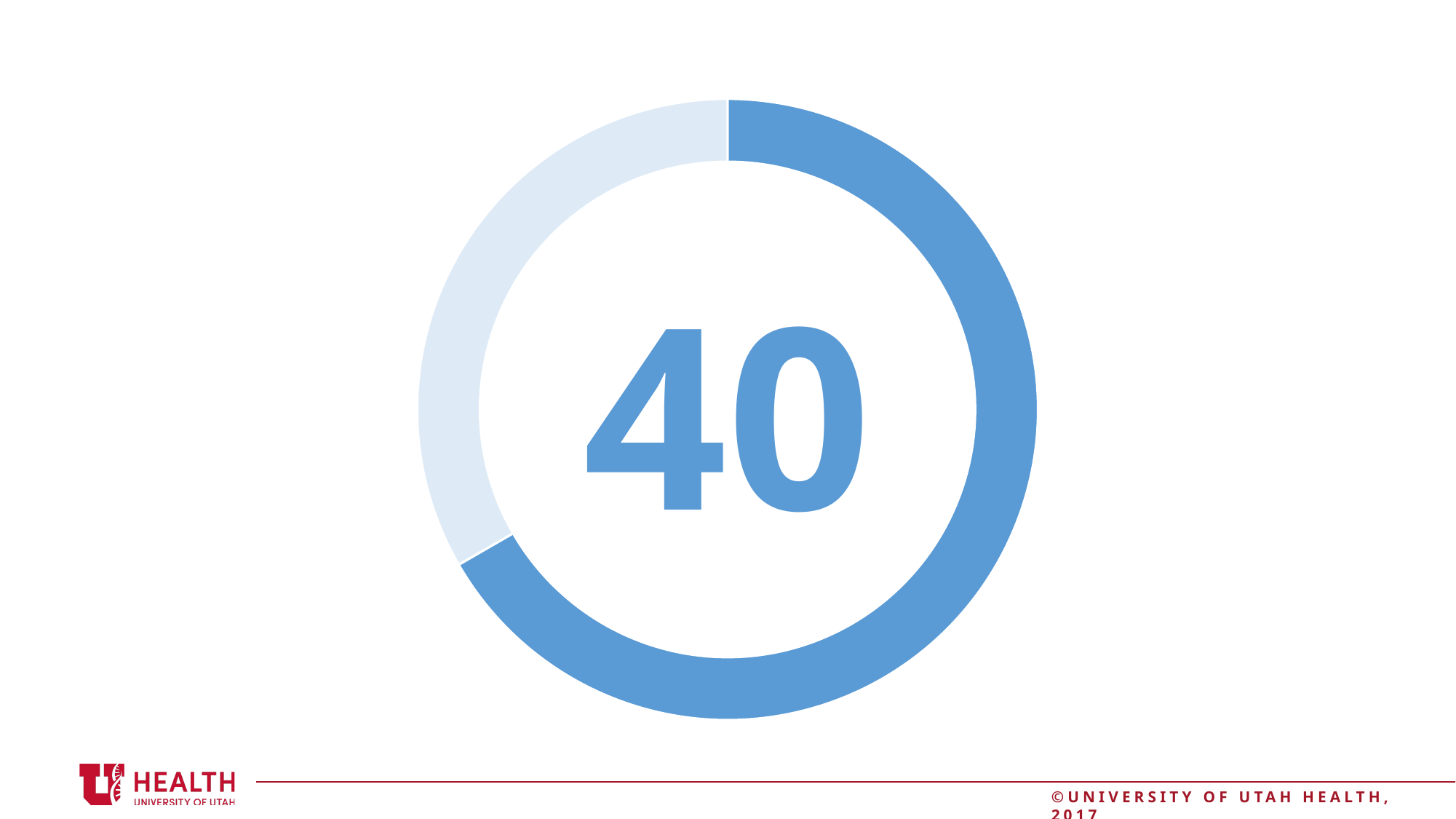
What kind of chart is shown on the slide? Donut chart Does the donut chart have a legend? No What number is printed in the centre of the donut chart? 40 How many segments does the donut chart have? 2 Which segment of the donut chart is larger, the dark blue one or the light blue one? The dark blue one Which segment of the donut chart is the smallest? The light blue segment